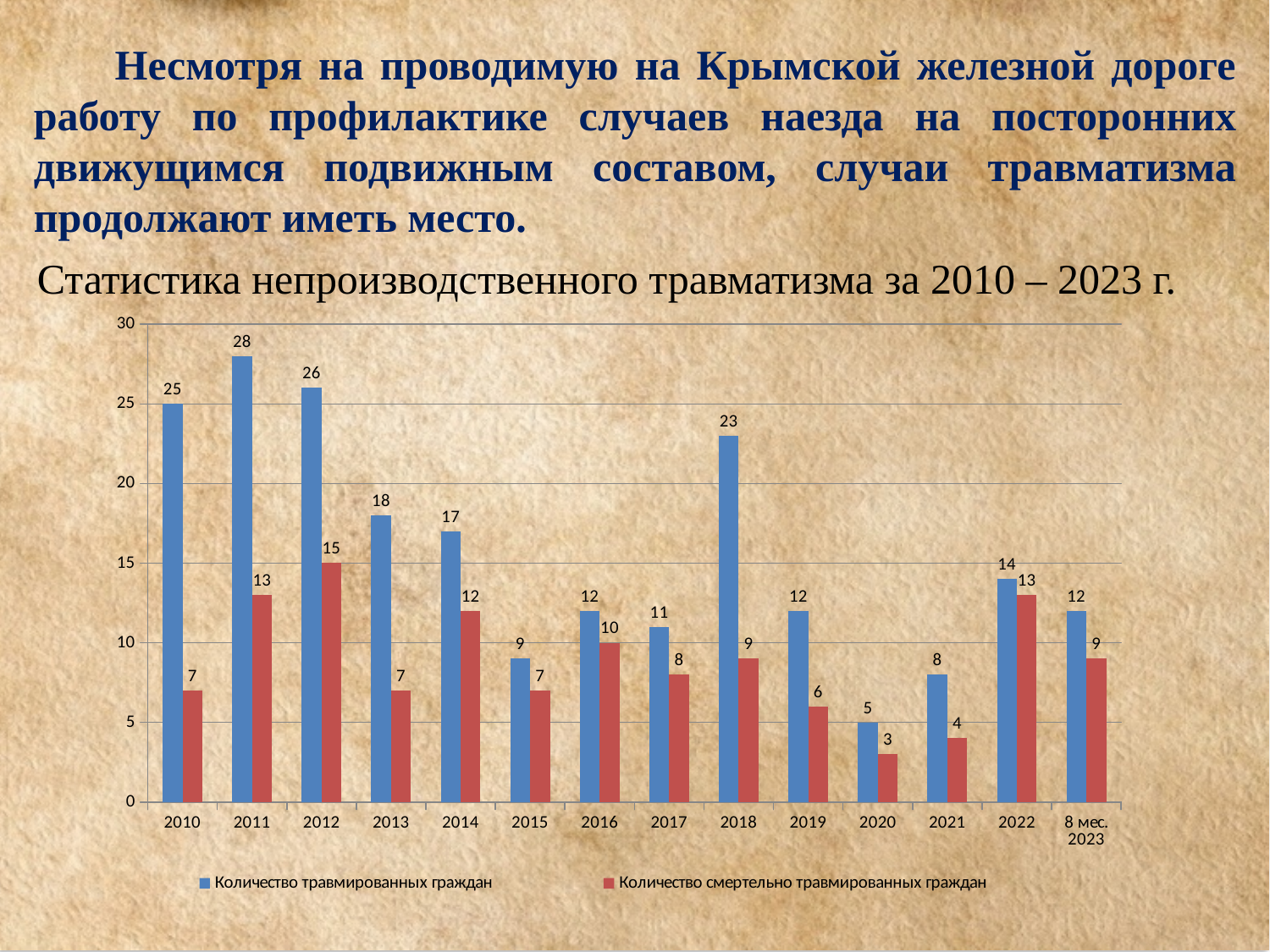
What is the title of the chart? Статистика непроизводственного травматизма за 2010 – 2023 г. How many categories are shown on the x axis? 14 What is the value of 'Количество смертельно травмированных граждан' for 2012? 15 Which is larger: 'Количество травмированных граждан' in 2013 or in 2014? 2013 What is the difference between 'Количество травмированных граждан' and 'Количество смертельно травмированных граждан' in 2018? 14 What type of chart is shown on the slide? bar chart What is the value of 'Количество травмированных граждан' for '8 мес. 2023'? 12 What is the value of 'Количество смертельно травмированных граждан' for 2014? 12 Which year has the highest value for 'Количество травмированных граждан'? 2011 What is the value of 'Количество травмированных граждан' for 2011? 28 How many series does the legend list? 2 Which category has the lowest value for 'Количество смертельно травмированных граждан'? 2020